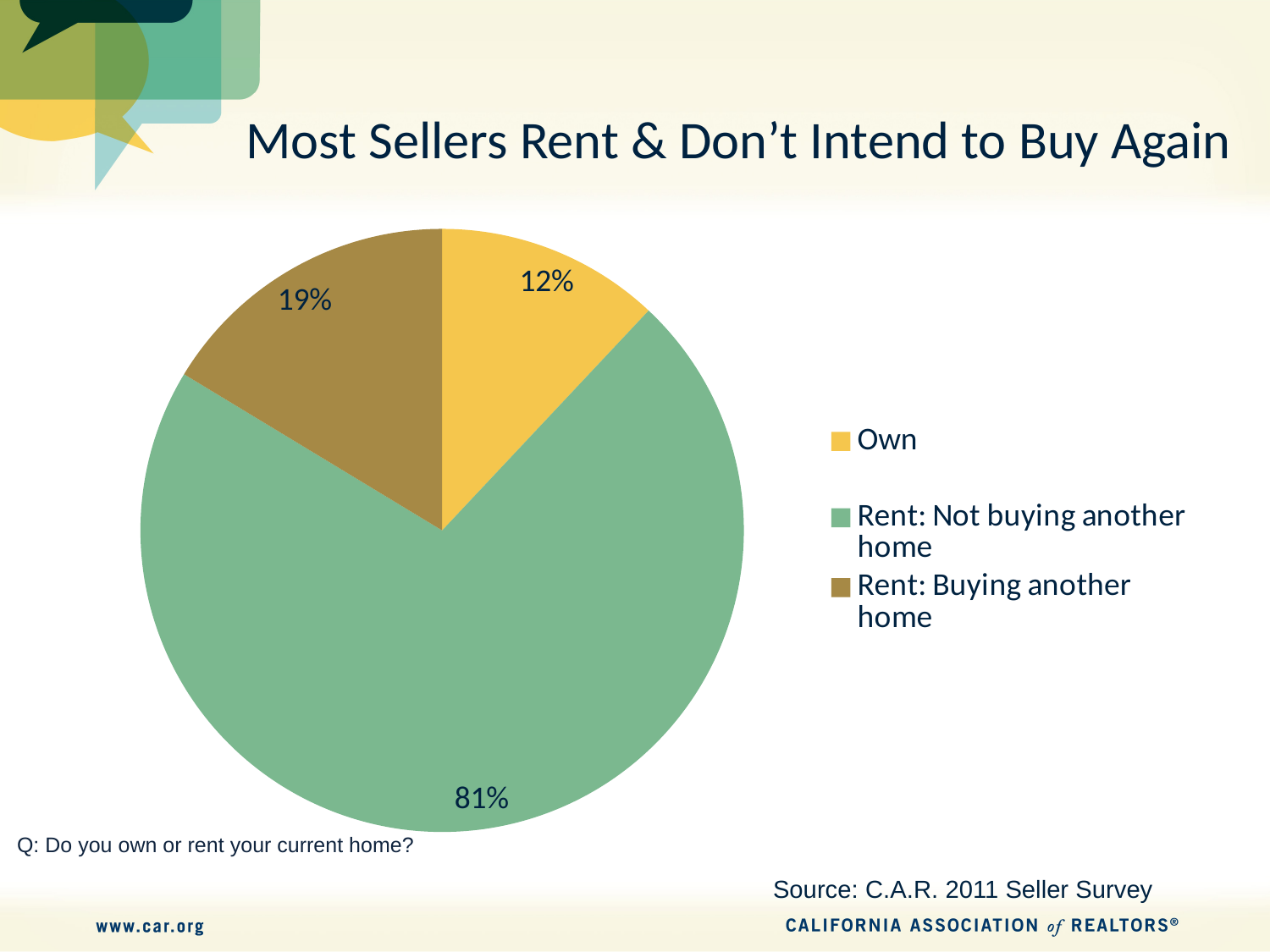
What colour is the 'Own' slice in the pie chart? yellow Which category has the smallest slice of the pie? Own How many slices does the pie chart have? 3 What percentage of sellers own their current home? 12% Which category has the largest slice of the pie? Rent: Not buying another home Which is larger: the share for 'Own' or the share for 'Rent: Buying another home'? Rent: Buying another home What percentage is shown for 'Rent: Not buying another home'? 81% How many categories does the legend list? 3 What is the difference between the 'Rent: Buying another home' share and the 'Own' share? 7% What type of chart is shown on the slide? pie chart What percentage is shown for 'Rent: Buying another home'? 19% What is the title of the slide containing the pie chart? Most Sellers Rent & Don't Intend to Buy Again